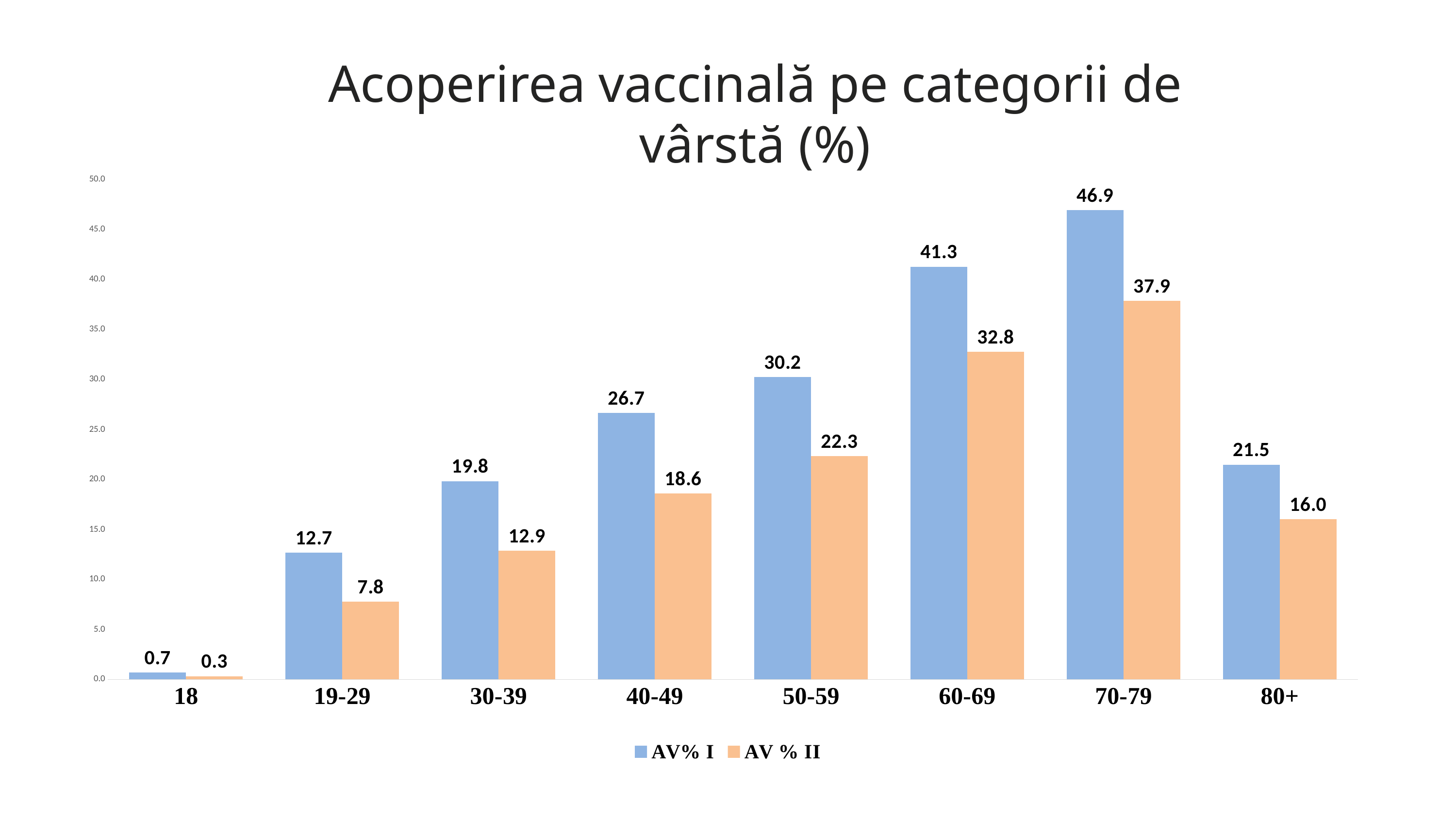
Does the AV% I value rise or fall from the 18 group to the 70-79 group? rise Is the AV % II value for the 50-59 age group greater or less than 20.0? greater Which age group has the highest AV% I value? 70-79 How many series does the legend list? 2 What colour represents the AV % II series? orange What type of chart is shown on the slide? bar chart How many age categories are shown on the x axis? 8 Which age group has the lowest AV % II value? 18 What is the AV% I value for the 60-69 age group? 41.3 What is the AV % II value for the 40-49 age group? 18.6 What is the difference between AV% I and AV % II for the 70-79 age group? 9.0 Which is larger for the 30-39 age group: AV% I or AV % II? AV% I